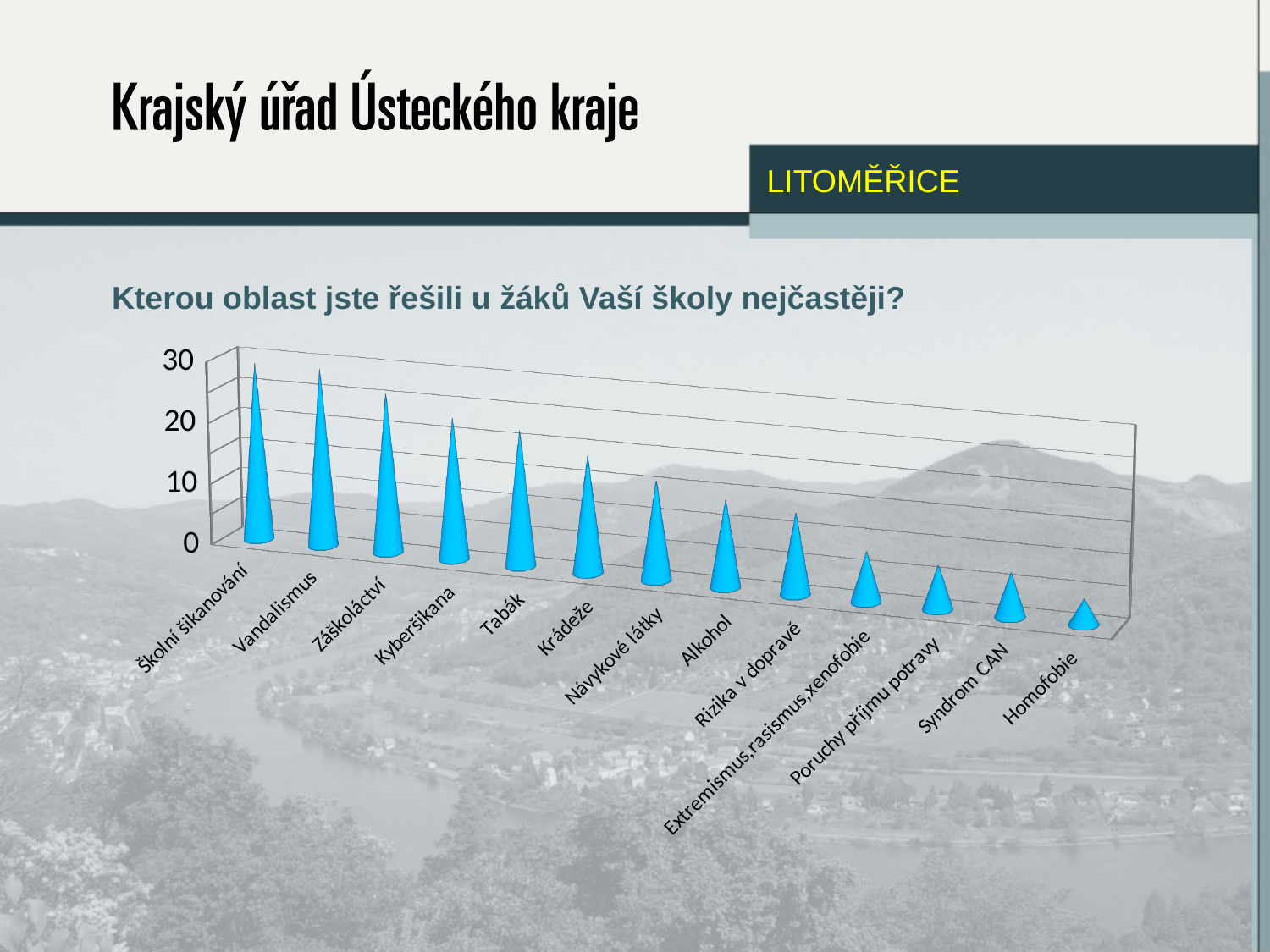
Which is larger, the value for Krádeže or the value for Homofobie? Krádeže Is the value for Školní šikanování greater or less than 20? greater Is the value for Homofobie greater or less than 10? less Which is larger, the value for Záškoláctví or the value for Alkohol? Záškoláctví Do the values rise or fall from left to right along the x axis? fall Which category has the highest value on the chart? Školní šikanování and Vandalismus (tied) Is the value for Syndrom CAN greater or less than 10? less What question is shown as the title above the chart? Kterou oblast jste řešili u žáků Vaší školy nejčastěji? What kind of chart is shown on the slide? bar chart Which category has the lowest value on the chart? Homofobie How many categories are shown on the chart? 13